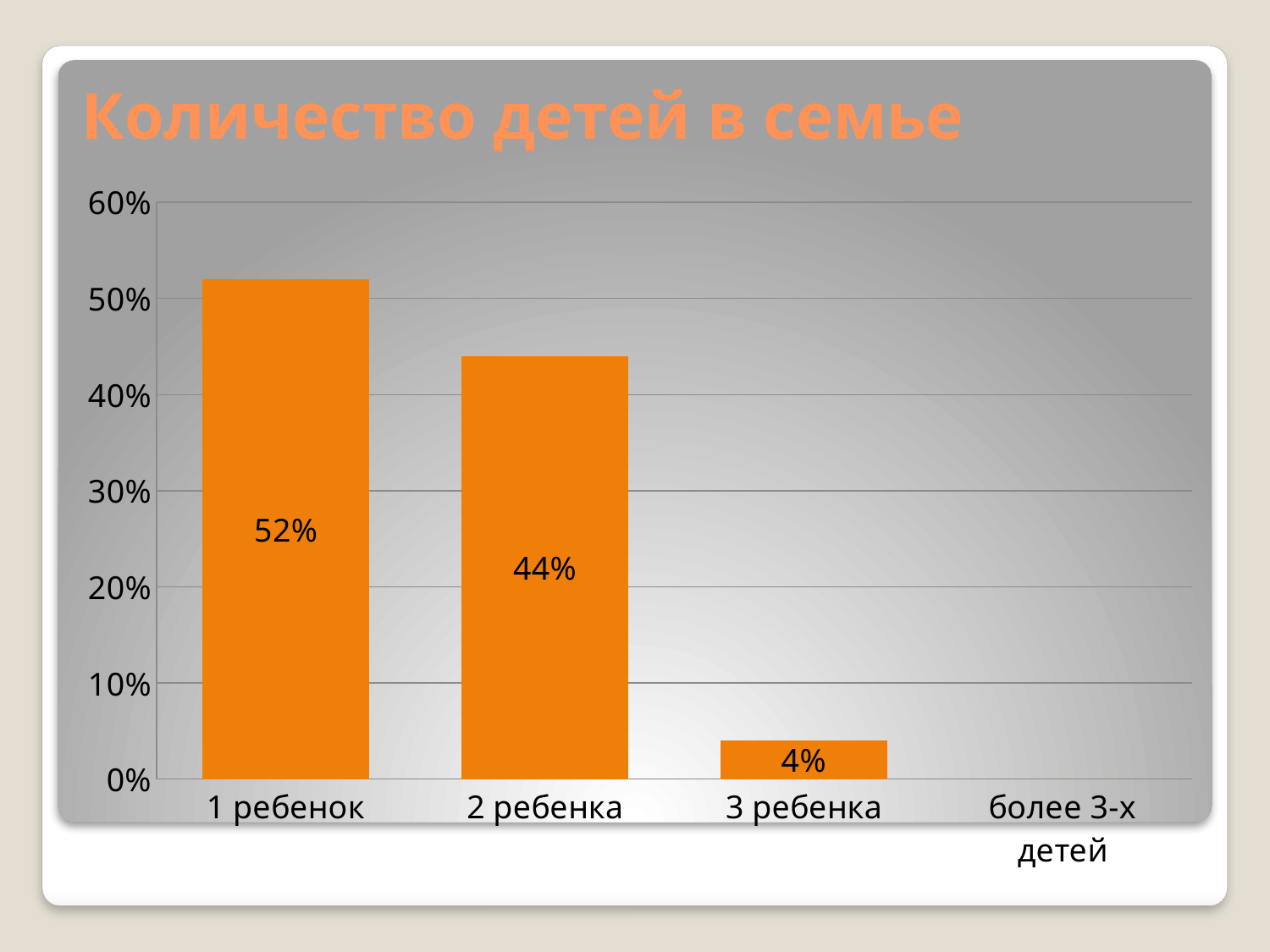
Which is larger, the value for 1 ребенок or the value for 2 ребенка? 1 ребенок How many categories are shown on the x axis? 4 What is the value for 3 ребенка? 4% Which category has the lowest value? более 3-х детей What is the value for 2 ребенка? 44% What is the difference between the values for 2 ребенка and 3 ребенка? 40% What kind of chart is shown on the slide? bar chart What is the value for 1 ребенок? 52% Which category has the highest value? 1 ребенок What is the title of the chart? Количество детей в семье Is the value for 2 ребенка greater or less than 40%? greater What is the difference between the values for 1 ребенок and 2 ребенка? 8%